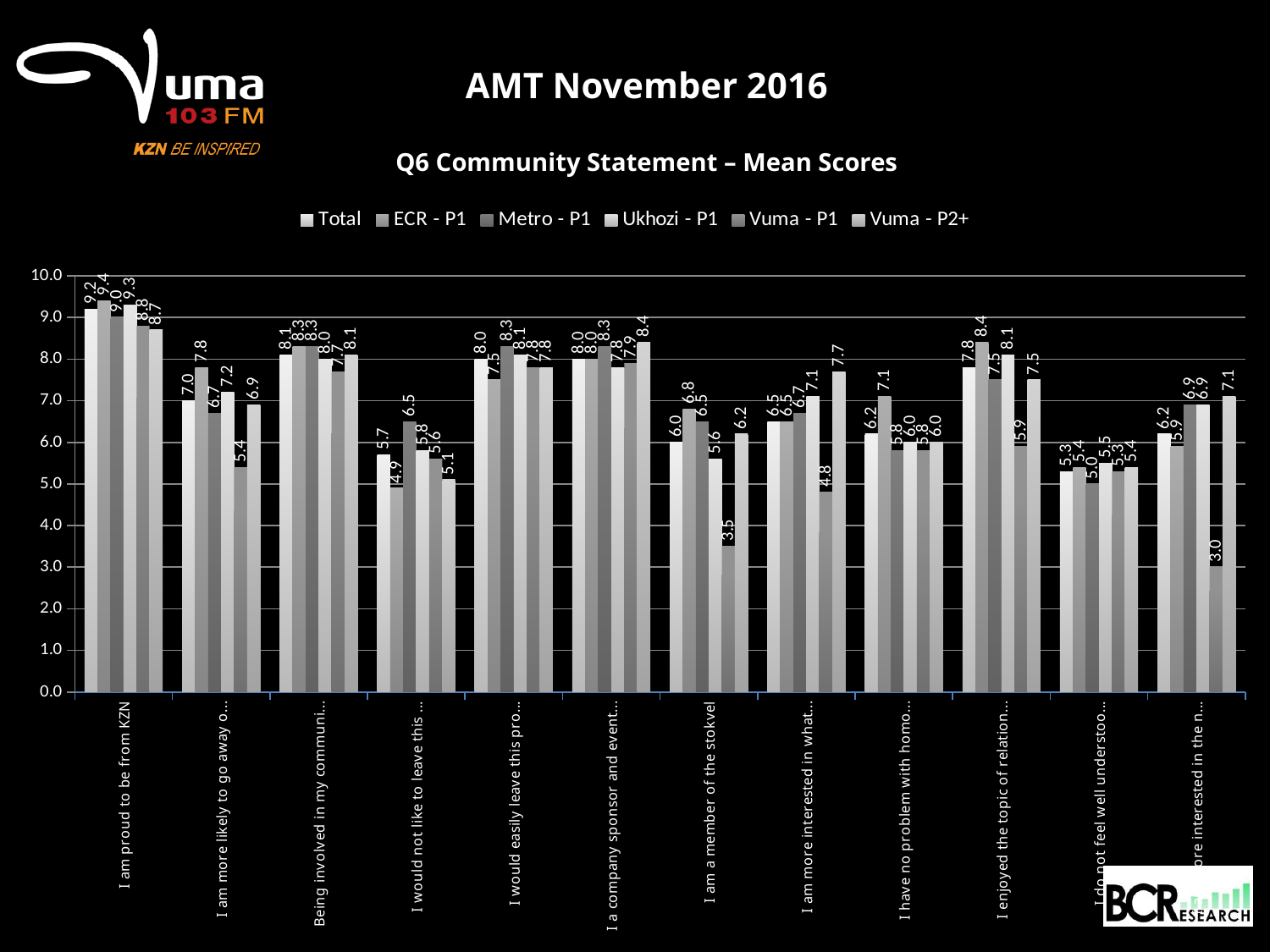
How many series does the legend list? 6 Which category has the highest Total mean score? I am proud to be from KZN Is the Vuma - P1 value for "I am proud to be from KZN" greater or less than 8.0? greater What is the Vuma - P2+ mean score for "I am a member of the stokvel"? 6.2 What is the difference between the ECR - P1 and Vuma - P1 mean scores for "I am a member of the stokvel"? 3.3 Which series has the highest mean score for "I am proud to be from KZN"? ECR - P1 What is the title of the chart? Q6 Community Statement – Mean Scores What kind of chart is shown on the slide? bar chart Which series has the lowest mean score for "I am a member of the stokvel"? Vuma - P1 What is the Vuma - P1 mean score for "I am a member of the stokvel"? 3.5 What is the Total mean score for "I am proud to be from KZN"? 9.2 How many statement categories are plotted along the x axis? 12